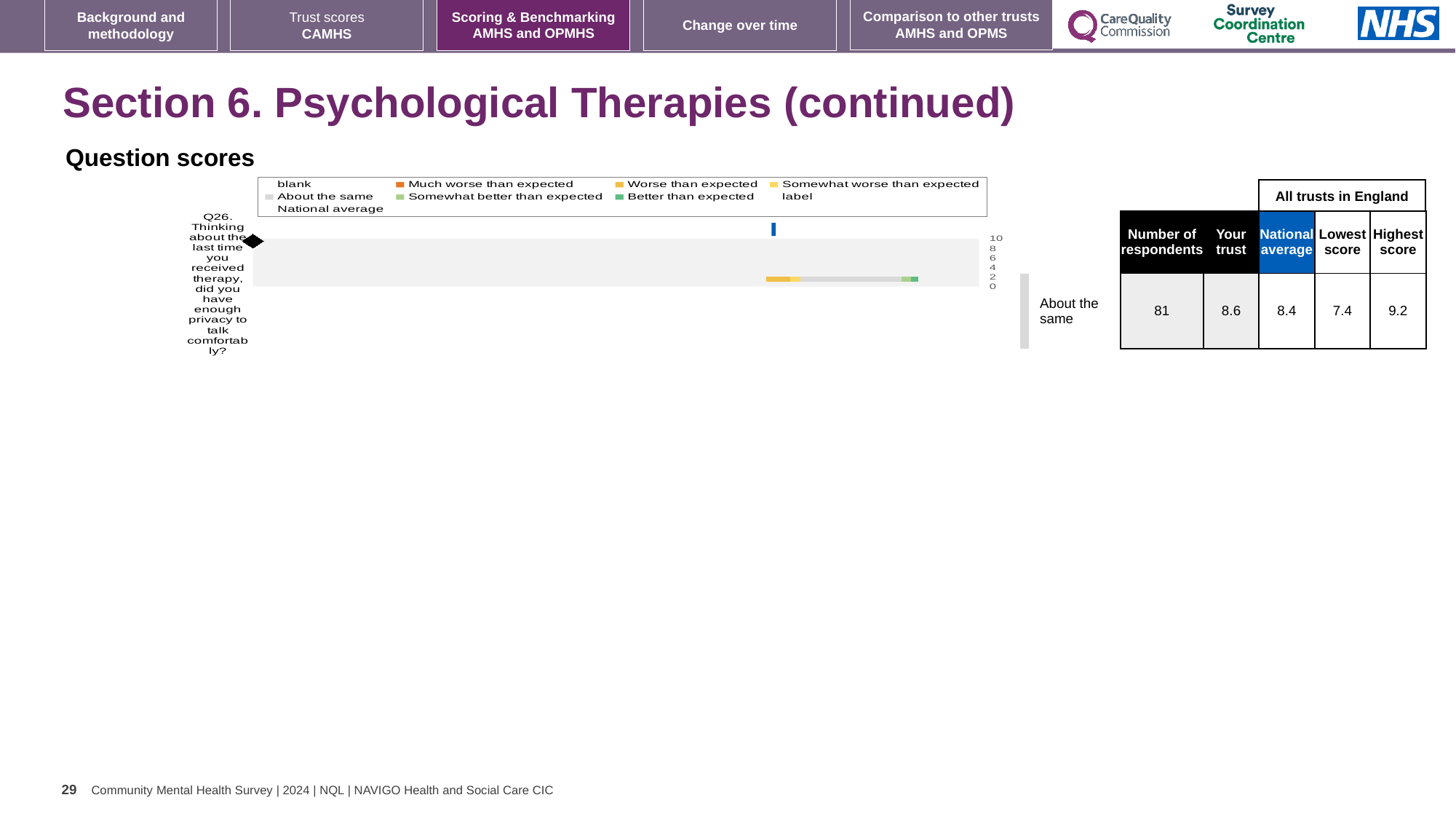
What is the national average score for Q26 shown in the table beside the chart? 8.4 How many respondents answered Q26? 81 What kind of chart is shown under 'Question scores'? bar chart Which benchmark category is the trust's Q26 score placed in? About the same What is the difference between the highest score and the lowest score for Q26? 1.8 How many questions are plotted in the Question scores chart? 1 What is the difference between the 'Your trust' score and the national average for Q26? 0.2 For Q26, which is larger: the 'Your trust' score or the national average? Your trust What is the highest score among all trusts in England for Q26? 9.2 What is the lowest score among all trusts in England for Q26? 7.4 What is the maximum value shown on the chart's score axis? 10 What is the 'Your trust' score for Q26 shown in the table beside the chart? 8.6